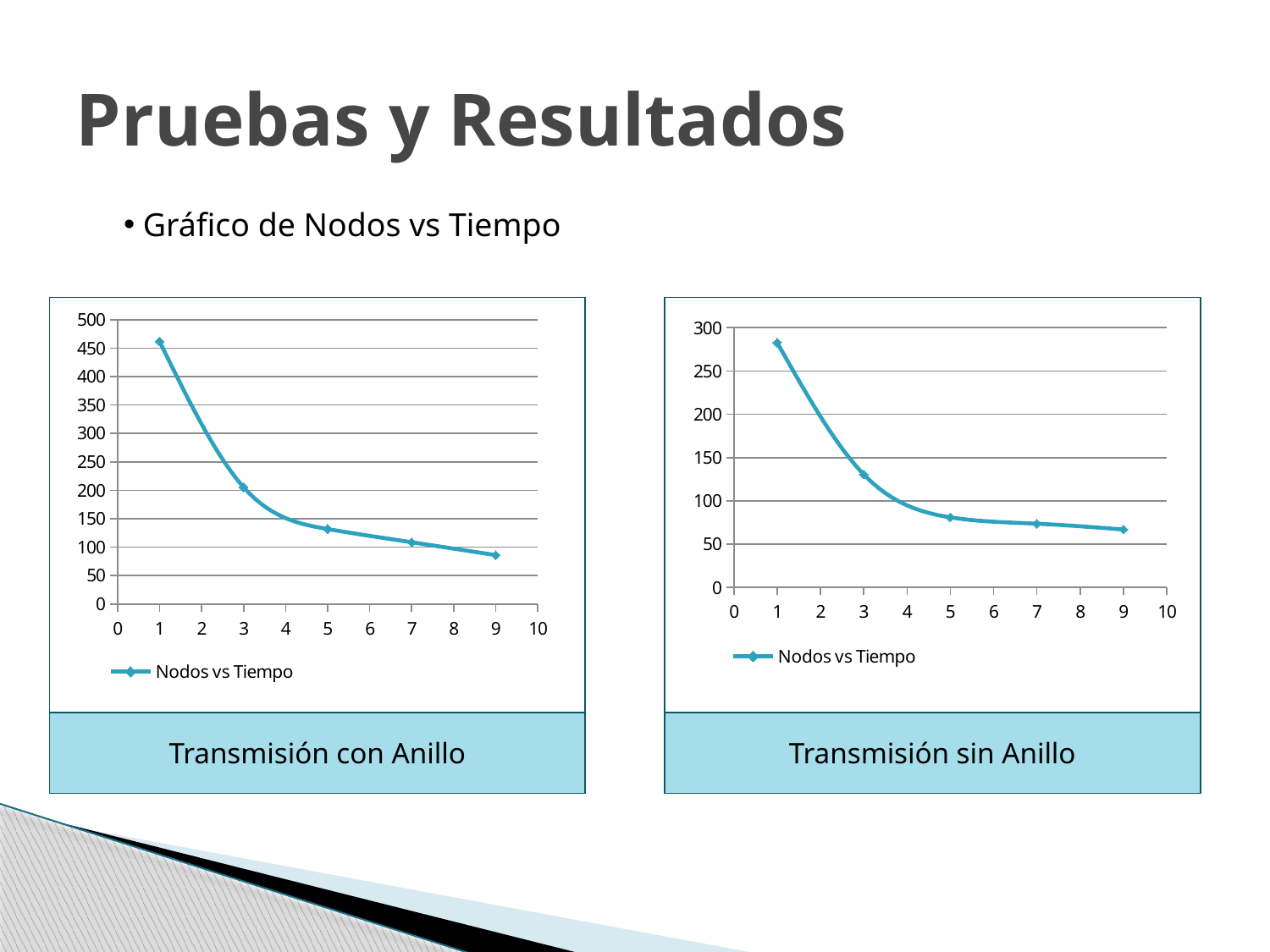
In the 'Transmisión con Anillo' chart, is the value at x = 1 greater or less than 400? greater In the 'Transmisión sin Anillo' chart, which is larger: the value at x = 3 or the value at x = 7? x = 3 In the 'Transmisión sin Anillo' chart, how many series does the legend list? 1 In the 'Transmisión con Anillo' chart, at which x value is the plotted value lowest? 9 In the 'Transmisión con Anillo' chart, do the values rise or fall as x increases? fall In the 'Transmisión sin Anillo' chart, is the value at x = 1 greater or less than 250? greater In the 'Transmisión sin Anillo' chart, at which x value is the plotted value highest? 1 What kind of chart is the 'Transmisión con Anillo' chart on the left? line chart In the 'Transmisión con Anillo' chart, how many data points are plotted? 5 In the 'Transmisión con Anillo' chart, is the value at x = 9 greater or less than 100? less What is the legend entry shown in the 'Transmisión con Anillo' chart? Nodos vs Tiempo